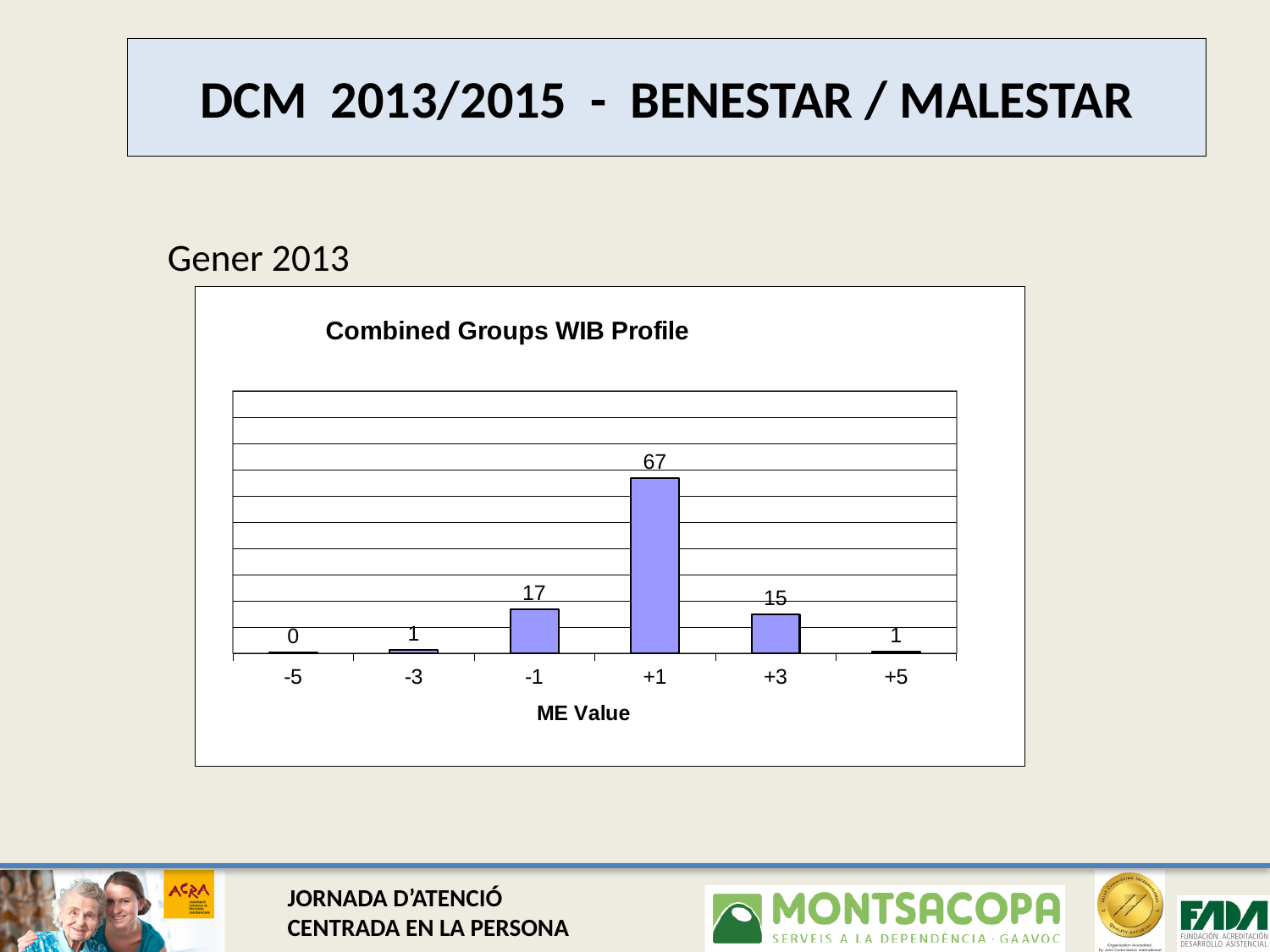
What is the value for ME Value -1? 17 What is the value for ME Value +3? 15 What is the value for ME Value +1? 67 Which is larger, the value for -1 or the value for +3? -1 What is the value for ME Value -5? 0 Which ME Value category has the highest value? +1 What is the difference between the values for +1 and -1? 50 What is the label of the x axis? ME Value What is the title of the chart? Combined Groups WIB Profile Which ME Value category has the lowest value? -5 What kind of chart is shown? bar chart How many ME Value categories are shown on the x axis? 6